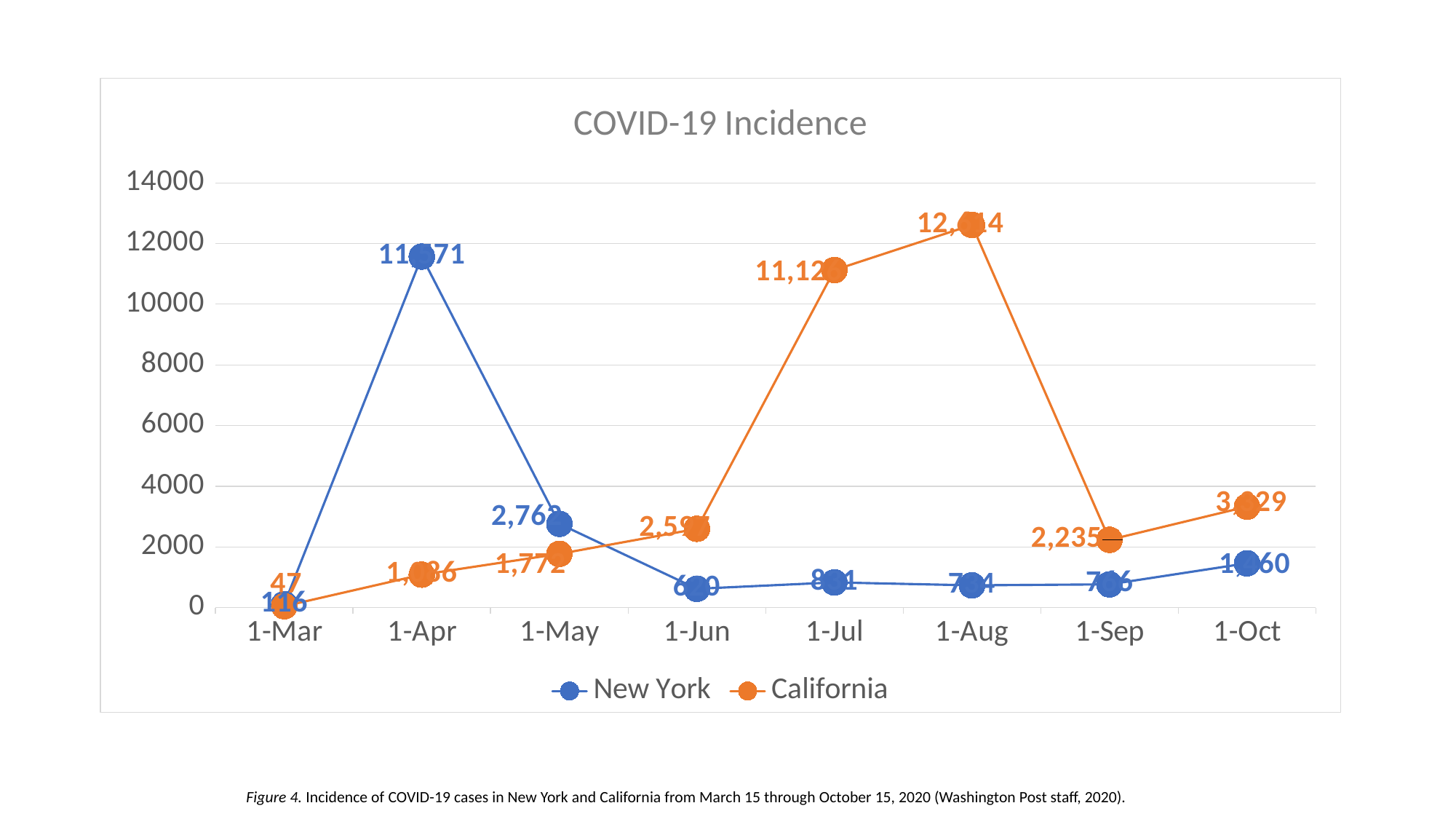
What is the California value on 1-Mar? 47 Which series has the larger value on 1-Aug, New York or California? California What is the difference between the California values on 1-Sep and 1-May? 463 What is the title of the chart? COVID-19 Incidence On which date does the California series reach its highest value? 1-Aug What is the California value on 1-May? 1,772 Is the New York value on 1-Apr greater or less than 10000? greater What is the California value on 1-Sep? 2,235 What type of chart is shown on the slide? Line chart How many dates are plotted along the x axis? 8 How many series does the legend list? 2 On which date does the New York series reach its highest value? 1-Apr